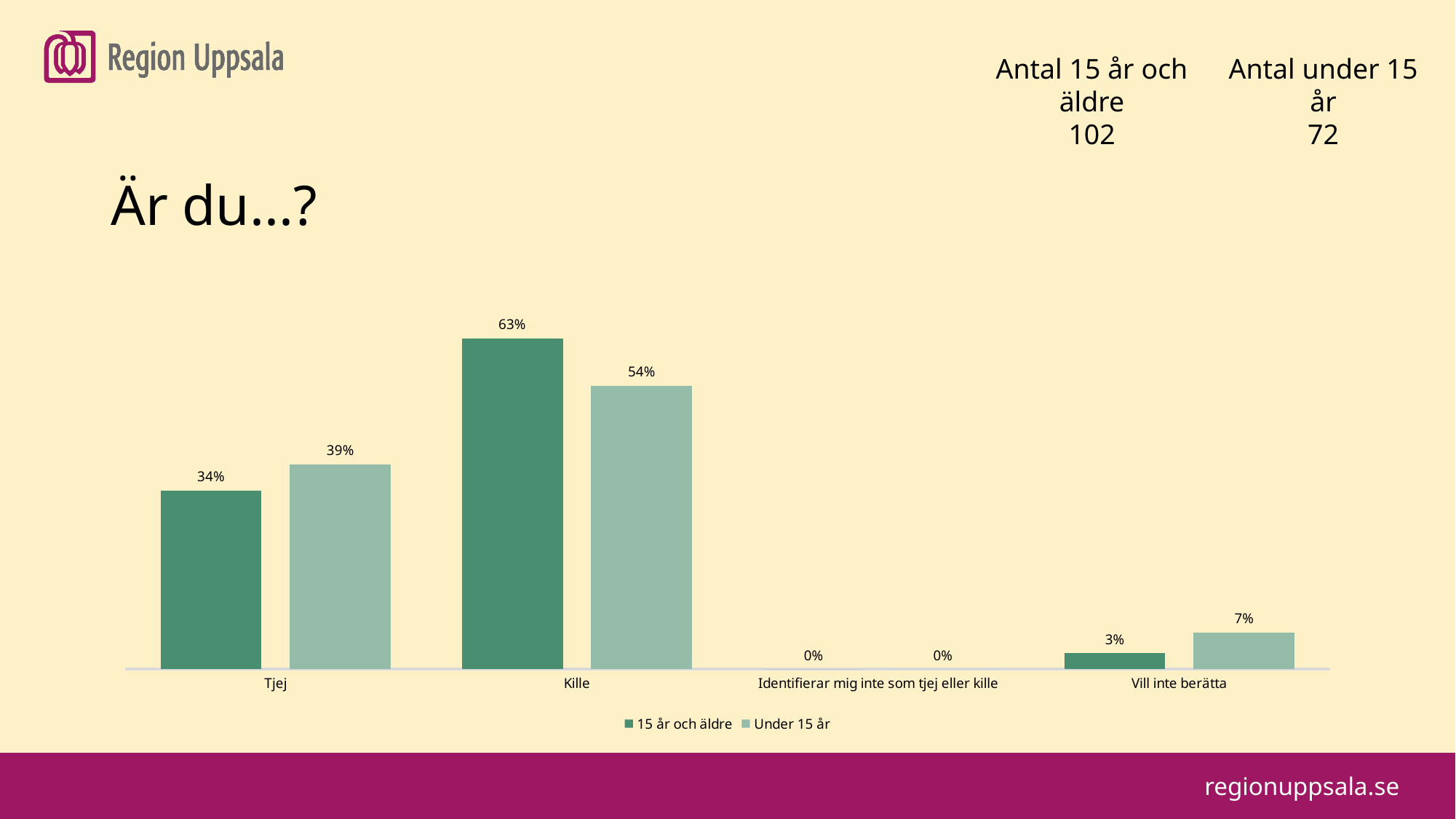
What is the value for Kille in the Under 15 år series? 54% What is the value for Vill inte berätta in the 15 år och äldre series? 3% Which category has the highest value in the 15 år och äldre series? Kille How many series does the legend list? 2 What is the value for Vill inte berätta in the Under 15 år series? 7% For Tjej, which series has the larger value: 15 år och äldre or Under 15 år? Under 15 år What is the title of the chart? Är du...? Which category has the lowest value in the Under 15 år series? Identifierar mig inte som tjej eller kille How many categories are shown on the x axis? 4 What is the value for Tjej in the 15 år och äldre series? 34% What kind of chart is shown on the slide? Bar chart What is the difference between the 15 år och äldre and Under 15 år values for Kille? 9 percentage points